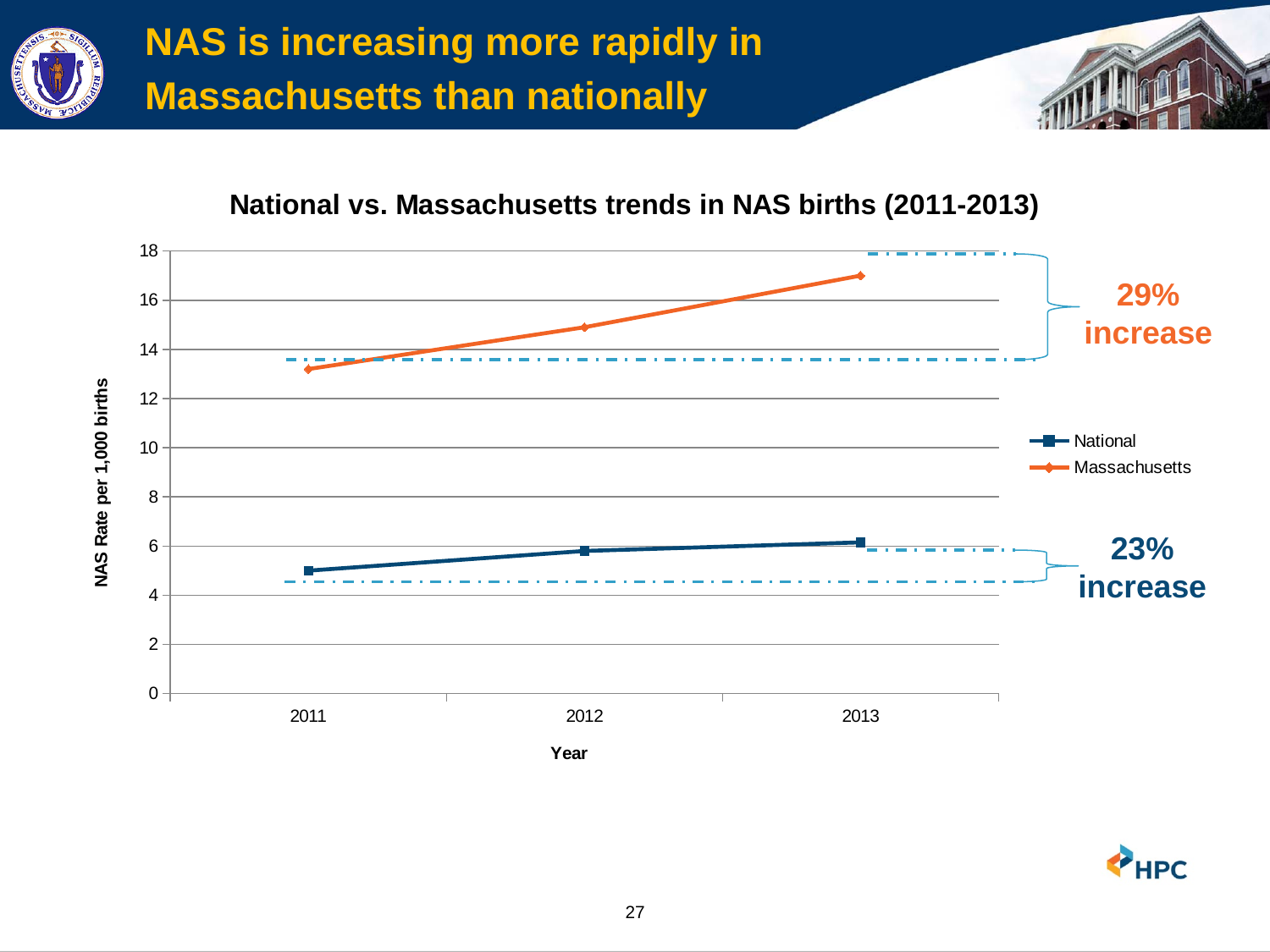
Is the Massachusetts value for 2013 greater or less than 16? greater Is the National value for 2011 greater or less than 6? less In which year is the National NAS rate lowest? 2011 In which year is the Massachusetts NAS rate highest? 2013 How many series does the legend list? 2 Does the National NAS rate rise or fall from 2011 to 2013? rise What is the label on the y axis of the chart? NAS Rate per 1,000 births How many years are plotted along the x axis? 3 What percentage increase is annotated for the Massachusetts series? 29% increase What kind of chart is shown on the slide? line chart Does the Massachusetts NAS rate rise or fall from 2011 to 2013? rise Which series has the higher NAS rate in 2013, National or Massachusetts? Massachusetts